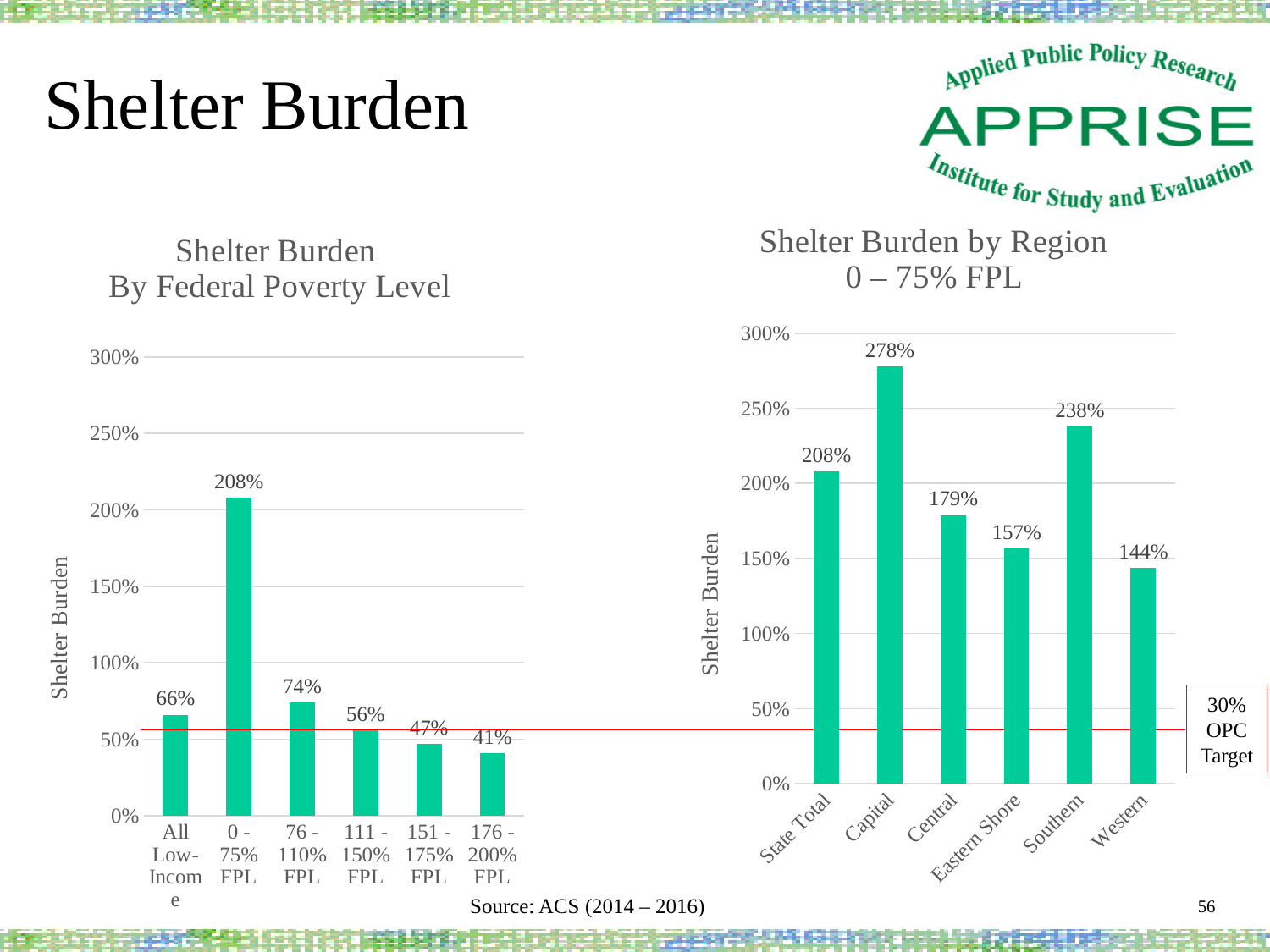
In the 'Shelter Burden by Region 0 – 75% FPL' chart, which region has the lowest shelter burden? Western In the 'Shelter Burden By Federal Poverty Level' chart, what is the shelter burden for the 0 - 75% FPL group? 208% In the 'Shelter Burden By Federal Poverty Level' chart, which group has the lowest shelter burden? 176 - 200% FPL In the 'Shelter Burden by Region 0 – 75% FPL' chart, what is the difference between the Capital and State Total values? 70% In the 'Shelter Burden by Region 0 – 75% FPL' chart, which is larger, the value for Southern or the value for Central? Southern In the 'Shelter Burden by Region 0 – 75% FPL' chart, what is the shelter burden for Eastern Shore? 157% In the 'Shelter Burden by Region 0 – 75% FPL' chart, what is the shelter burden for Capital? 278% In the 'Shelter Burden By Federal Poverty Level' chart, what is the difference between the 76 - 110% FPL and 111 - 150% FPL values? 18% In the 'Shelter Burden By Federal Poverty Level' chart, how many categories are shown on the x axis? 6 In the 'Shelter Burden by Region 0 – 75% FPL' chart, which region has the highest shelter burden? Capital What kind of chart is the 'Shelter Burden by Region 0 – 75% FPL' chart? Bar chart In the 'Shelter Burden By Federal Poverty Level' chart, what is the shelter burden for All Low-Income? 66%